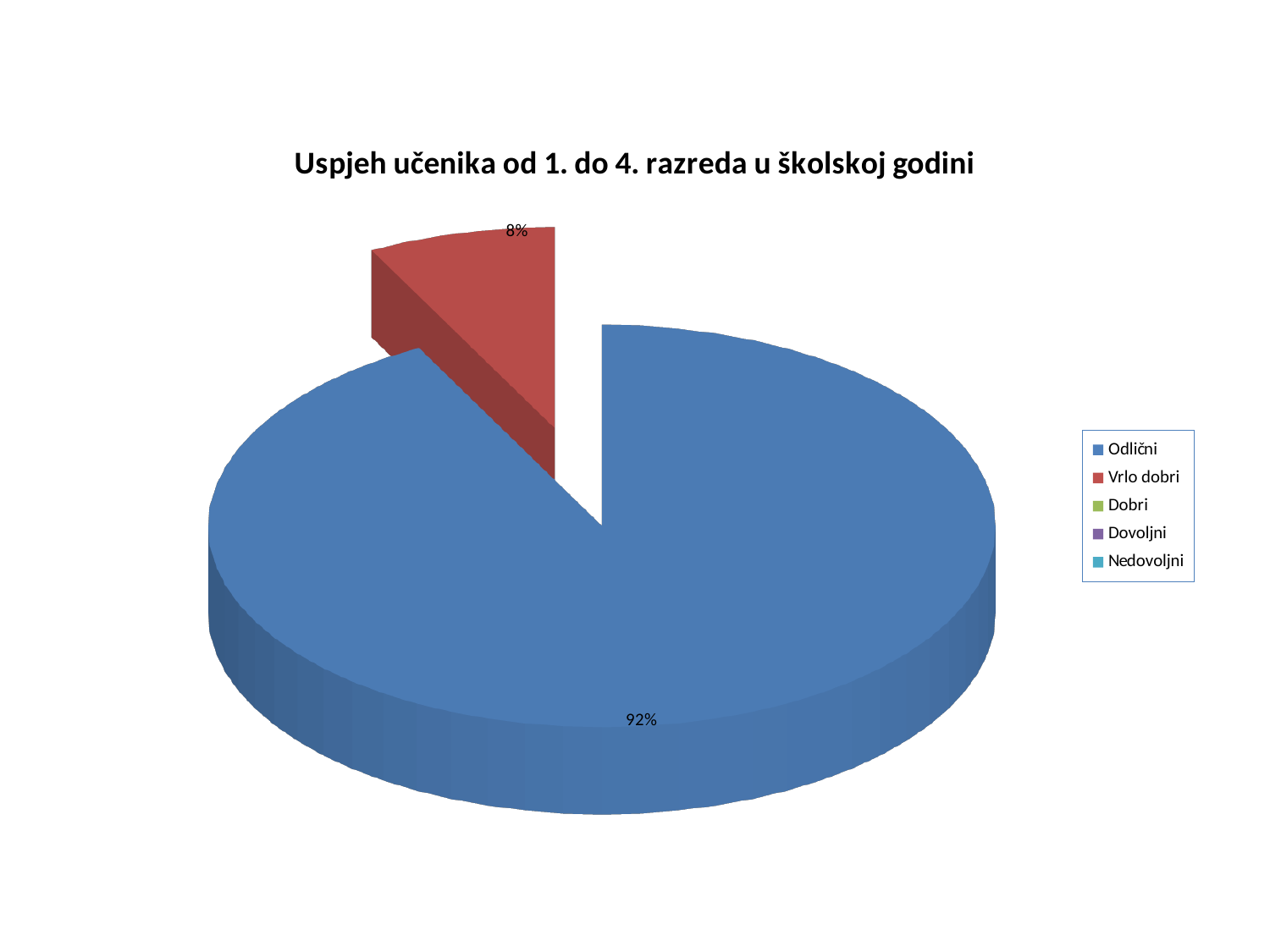
What is the difference in percentage points between the Odlični and Vrlo dobri slices? 84 How many slices are visible in the pie? 2 What colour is the Vrlo dobri slice? red What is the total of the two labelled slices? 100% What is the title of the chart? Uspjeh učenika od 1. do 4. razreda u školskoj godini What kind of chart is shown on the slide? pie chart Which of the two visible slices is larger, Odlični or Vrlo dobri? Odlični How many entries does the legend list? 5 What share of the pie is labelled for Vrlo dobri? 8% Which category has the largest slice of the pie? Odlični What share of the pie is labelled for Odlični? 92%